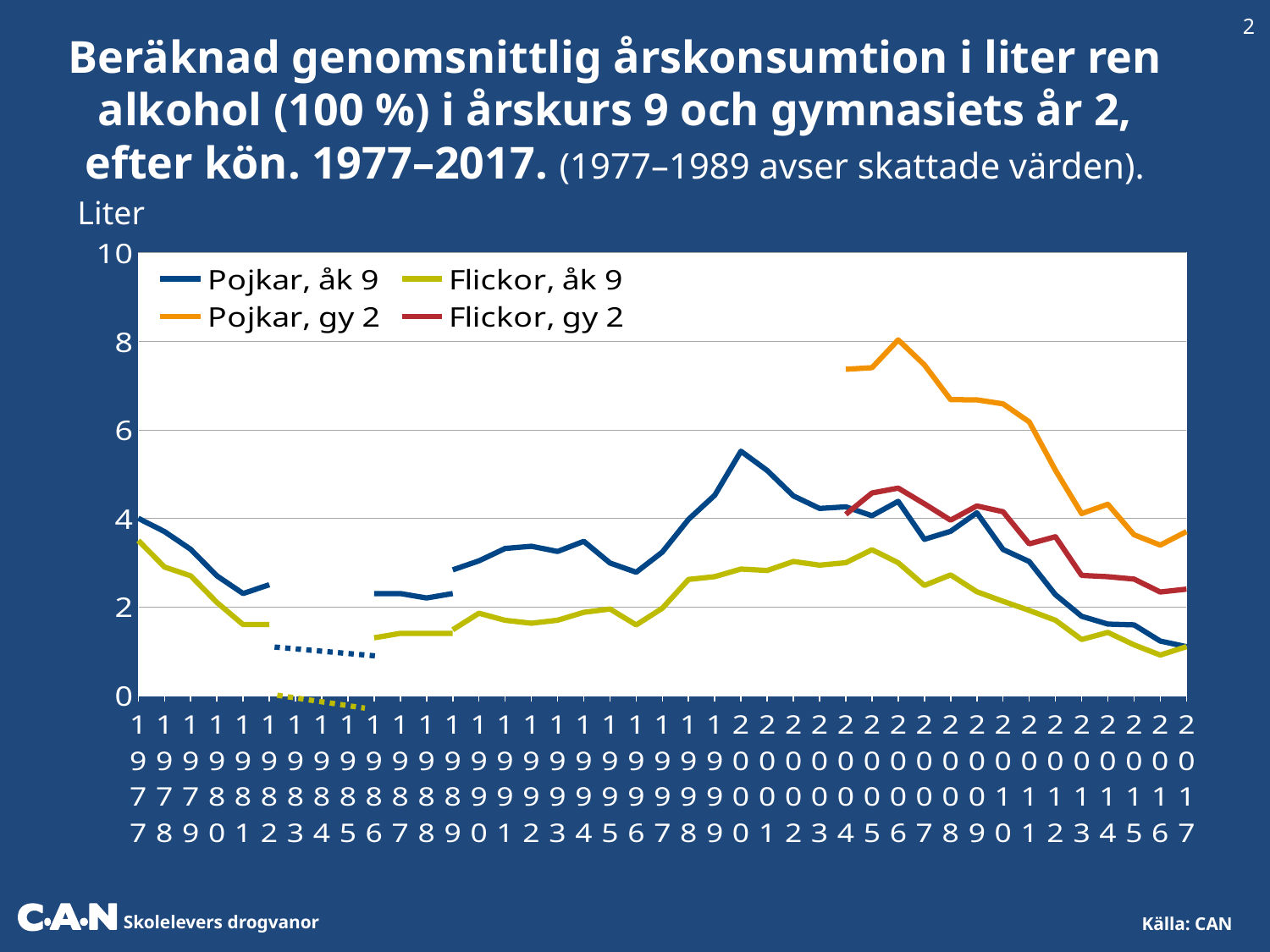
What kind of chart is shown on the slide? Line chart Is the value for Pojkar, åk 9 in 2000 greater or less than 4? greater Is the value for Pojkar, gy 2 in 2004 greater or less than 6? greater Does the Pojkar, gy 2 series rise or fall from 2006 to 2017? Fall Is the value for Flickor, åk 9 in 2017 greater or less than 2? less Which series reaches the highest value anywhere on the chart? Pojkar, gy 2 What is the label on the y axis? Liter Which series is drawn in orange? Pojkar, gy 2 In 2010, which is larger: Pojkar, gy 2 or Flickor, gy 2? Pojkar, gy 2 In which year does the Pojkar, gy 2 series reach its peak? 2006 What are the first and last years shown on the x axis? 1977 and 2017 How many series does the legend list? 4